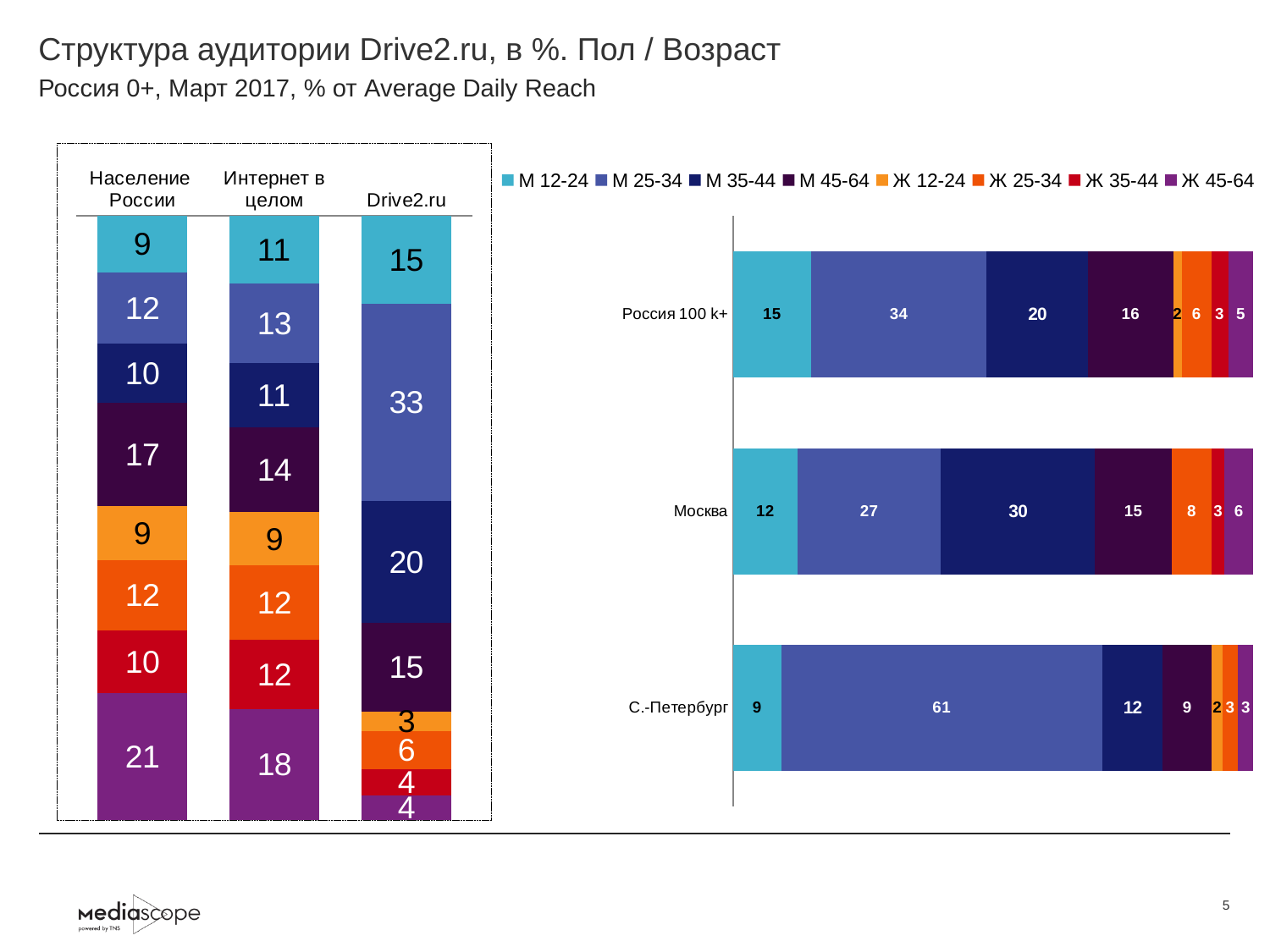
In the left chart, which segment is the largest in the Drive2.ru bar? М 25-34 How many bars are shown in the right chart? 3 In the right chart, which is larger: the М 35-44 value for Москва or for Россия 100 k+? Москва In the left chart, what is the value of the Ж 45-64 segment for Население России? 21 In the left chart, what is the total of the Drive2.ru stacked bar? 100 How many series does the legend list? 8 In the right chart, what is the value of the М 35-44 segment for Москва? 30 In the left chart, what is the difference between the М 25-34 values for Drive2.ru and Интернет в целом? 20 In the right chart, what is the value of the М 25-34 segment for С.-Петербург? 61 In the left chart, what is the value of the М 25-34 segment for Drive2.ru? 33 What kind of chart is the right chart? Stacked bar chart In the left chart, which segment is the smallest in the Drive2.ru bar? Ж 12-24